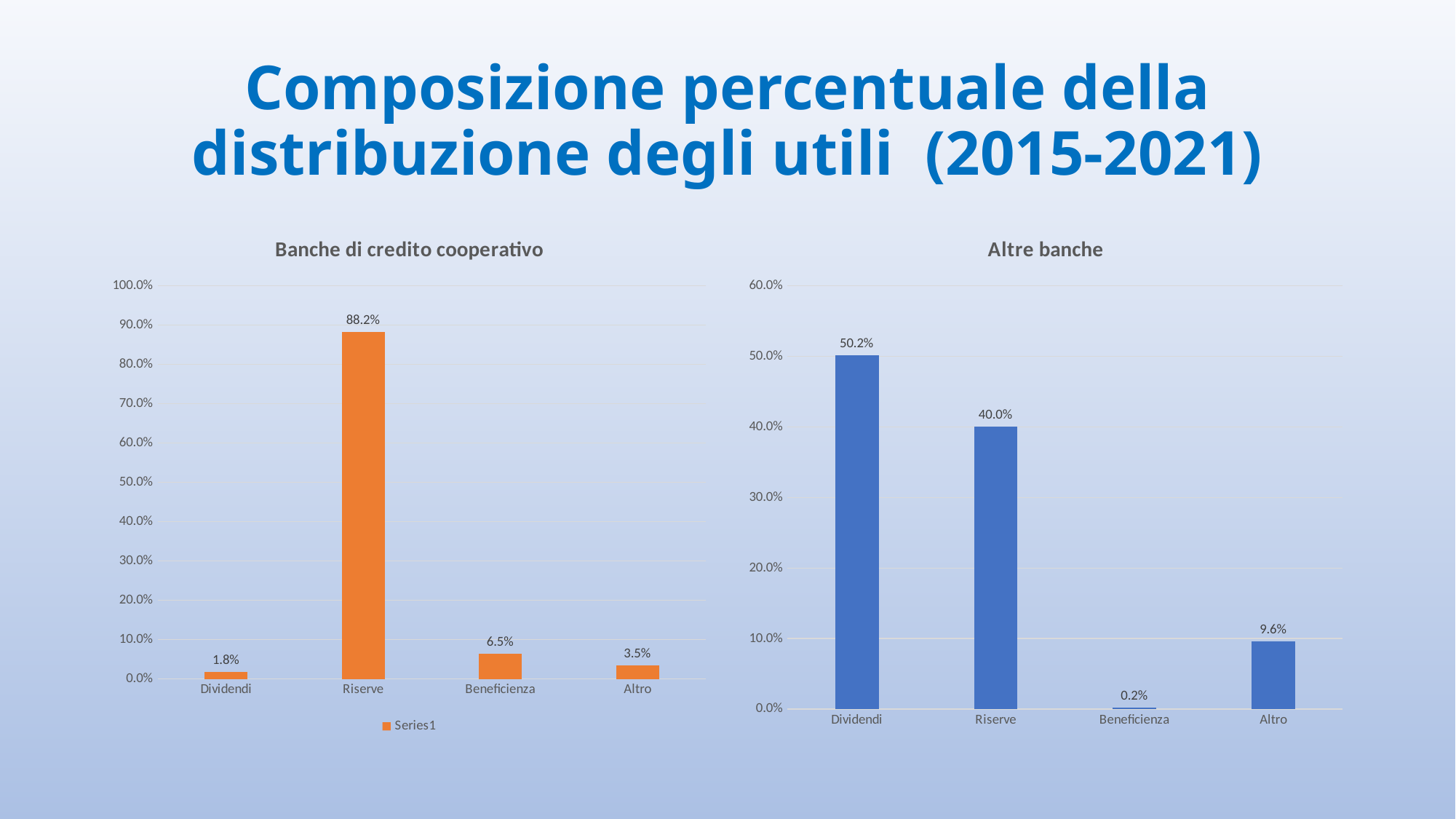
How many categories are shown in the 'Altre banche' chart? 4 In the 'Banche di credito cooperativo' chart, what is the value for Riserve? 88.2% What kind of chart is the 'Banche di credito cooperativo' chart? bar chart In the 'Altre banche' chart, what is the value for Dividendi? 50.2% In the 'Banche di credito cooperativo' chart, which category has the lowest value? Dividendi In the 'Altre banche' chart, what is the difference between Dividendi and Riserve? 10.2% In the 'Banche di credito cooperativo' chart, which category has the highest value? Riserve In the 'Altre banche' chart, what is the value for Beneficienza? 0.2% In the 'Banche di credito cooperativo' chart, which is larger, Beneficienza or Altro? Beneficienza In the 'Altre banche' chart, which category has the lowest value? Beneficienza In the 'Altre banche' chart, is the value for Altro greater or less than 10.0%? less What is the legend entry shown under the 'Banche di credito cooperativo' chart? Series1